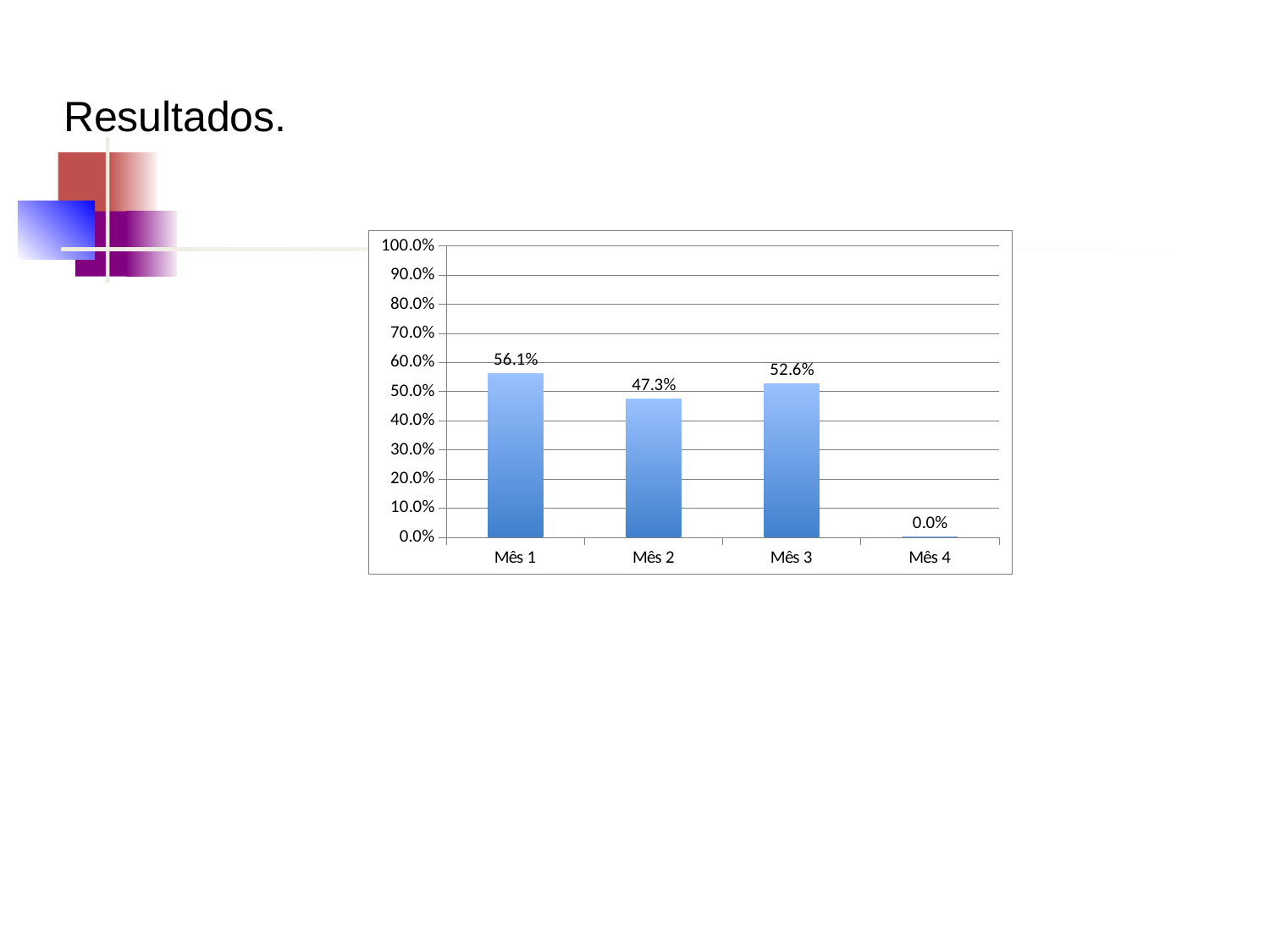
Which category has the lowest value? Mês 4 What is the difference between the values for Mês 3 and Mês 2? 5.3% What kind of chart is shown on the slide? bar chart What is the value for Mês 4? 0.0% Which is larger, the value for Mês 2 or the value for Mês 3? Mês 3 What is the value for Mês 2? 47.3% How many categories are shown on the x axis? 4 What is the value for Mês 3? 52.6% Is the value for Mês 1 greater or less than 50.0%? greater What is the value for Mês 1? 56.1% Which category has the highest value? Mês 1 What is the difference between the values for Mês 1 and Mês 2? 8.8%